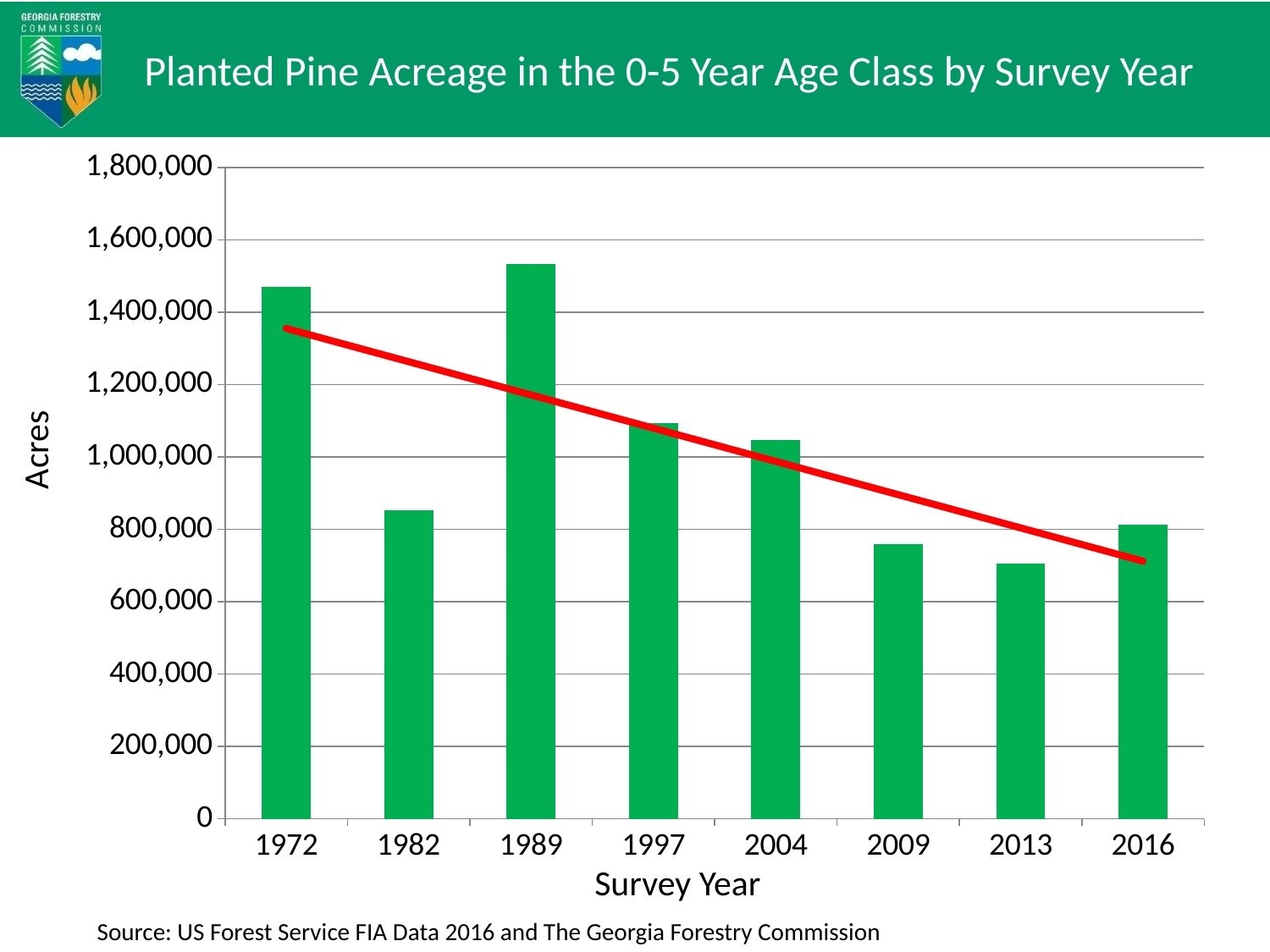
What is the label on the vertical axis of the chart? Acres How many survey years are plotted on the chart? 8 Is the value for 2004 greater or less than 1,000,000? greater What kind of chart is shown on the slide? bar chart Is the value for 2009 greater or less than 800,000? less Is the value for 2016 greater or less than 1,000,000? less Which survey year has the larger value, 1982 or 1997? 1997 Which survey year has the lowest planted pine acreage in the 0-5 year age class? 2013 According to the red trend line, do the values generally rise or fall across the survey years? fall Which survey year has the highest planted pine acreage in the 0-5 year age class? 1989